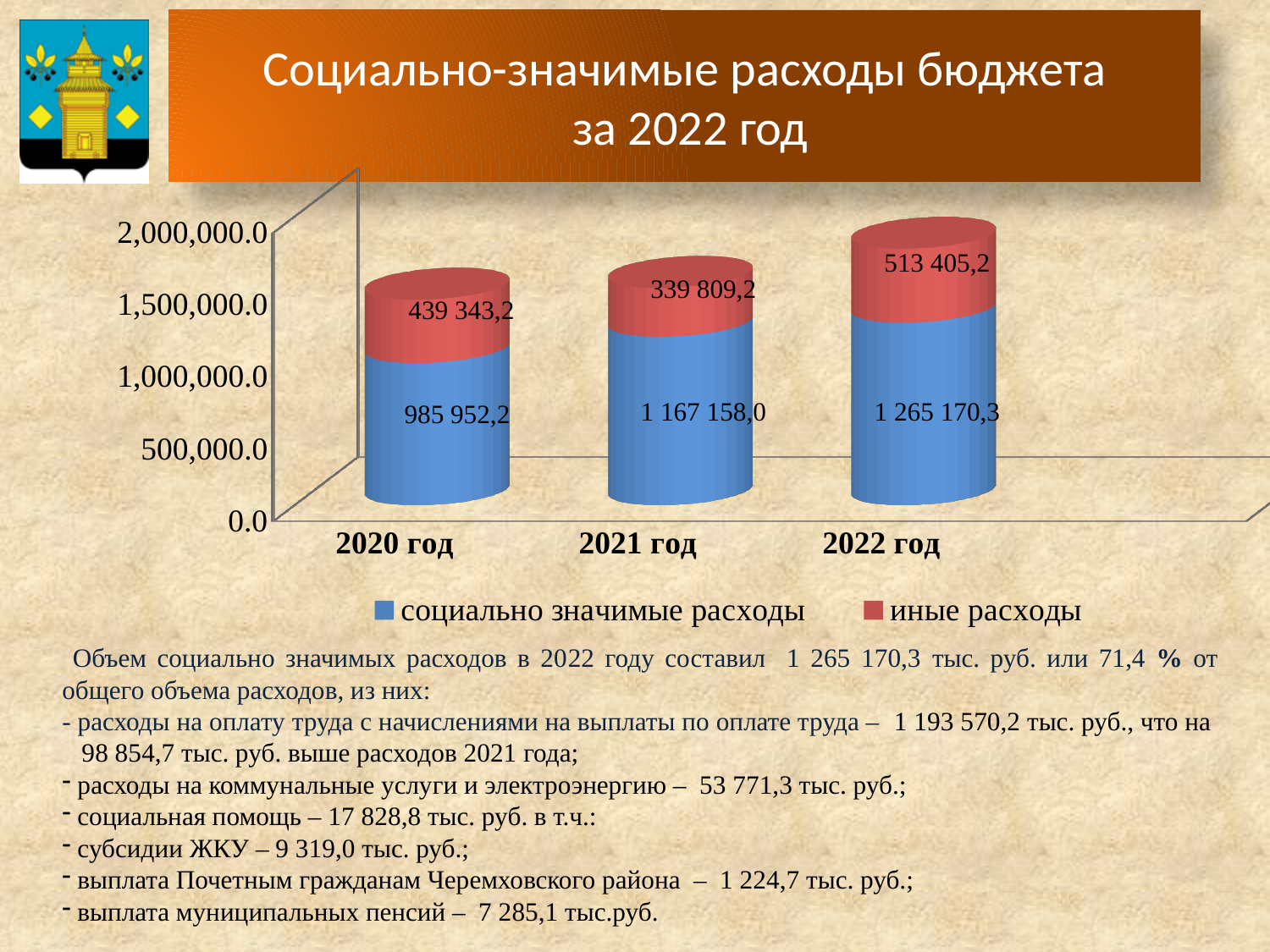
How many series does the legend list? 2 Do the values of социально значимые расходы rise or fall from 2020 год to 2022 год? Rise What is the total of the stacked bar for 2022 год? 1 778 575,5 What is the difference between социально значимые расходы in 2022 год and 2021 год? 98 012,3 What is the value of социально значимые расходы for 2022 год? 1 265 170,3 What is the value of социально значимые расходы for 2020 год? 985 952,2 Which year has the lowest value of социально значимые расходы? 2020 год Which year has the highest value of иные расходы? 2022 год What kind of chart is shown on the slide? Stacked bar chart What is the value of иные расходы for 2021 год? 339 809,2 Which is larger: иные расходы in 2020 год or in 2021 год? 2020 год How many years are shown on the x axis? 3